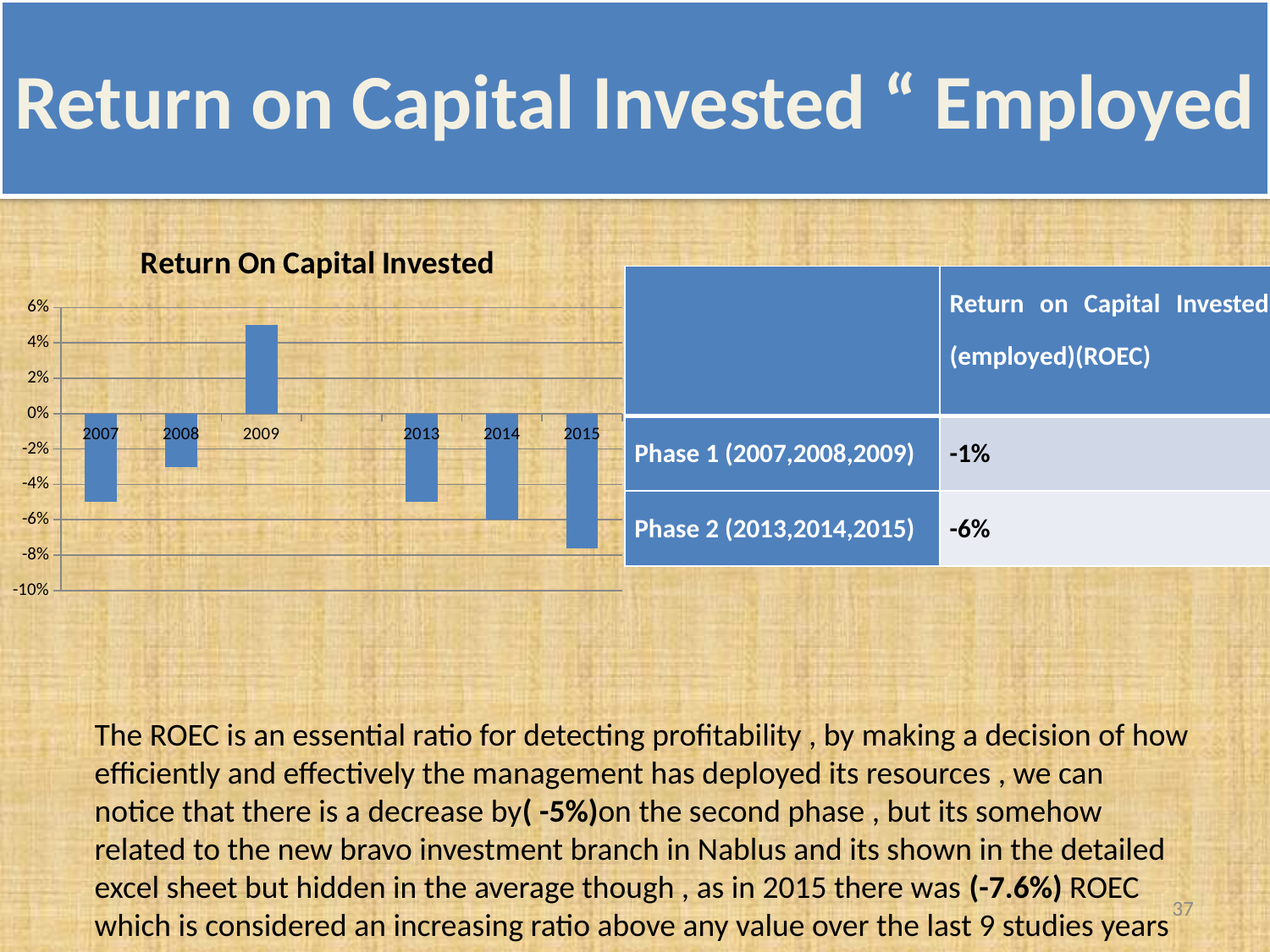
Which year has the larger value, 2008 or 2014? 2008 What is the title of the chart? Return On Capital Invested Do the values rise or fall from 2013 to 2015? fall Is the value for 2015 greater or less than -6%? less Is the value for 2008 greater or less than -4%? greater How many years on the chart have a positive Return On Capital Invested? 1 How many years are plotted on the Return On Capital Invested chart? 6 Which year has the lowest Return On Capital Invested on the chart? 2015 Is the value for 2007 greater or less than -4%? less What kind of chart is shown on the slide? bar chart Which year has the highest Return On Capital Invested on the chart? 2009